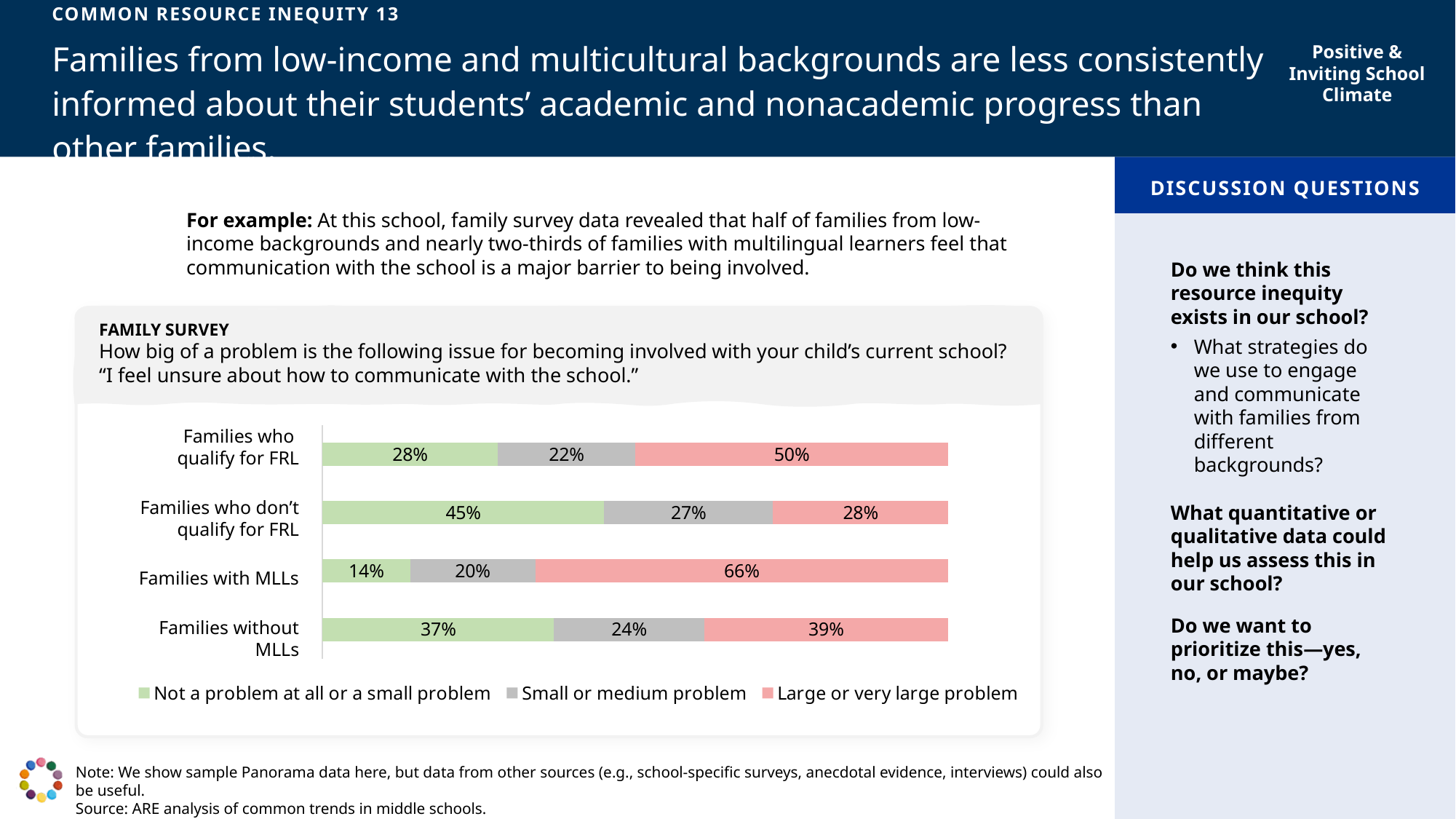
What kind of chart is shown on the slide? Stacked bar chart What is the difference between the large or very large problem share for families who qualify for FRL and those who don't qualify for FRL? 22 percentage points Which family group has the lowest share reporting not a problem at all or a small problem? Families with MLLs Which is larger: the not a problem at all or a small problem share for families without MLLs or for families who qualify for FRL? Families without MLLs What percentage of families who don't qualify for FRL said it is not a problem at all or a small problem? 45% What percentage of families with MLLs said communicating with the school is a large or very large problem? 66% Which family group has the highest share reporting a large or very large problem? Families with MLLs What is the total of the three segments for the families who qualify for FRL bar? 100% Which colour represents the 'Large or very large problem' series in the chart? Red (pink) What percentage of families without MLLs said it is a small or medium problem? 24% How many series does the legend list? 3 How many family groups are shown in the chart? 4